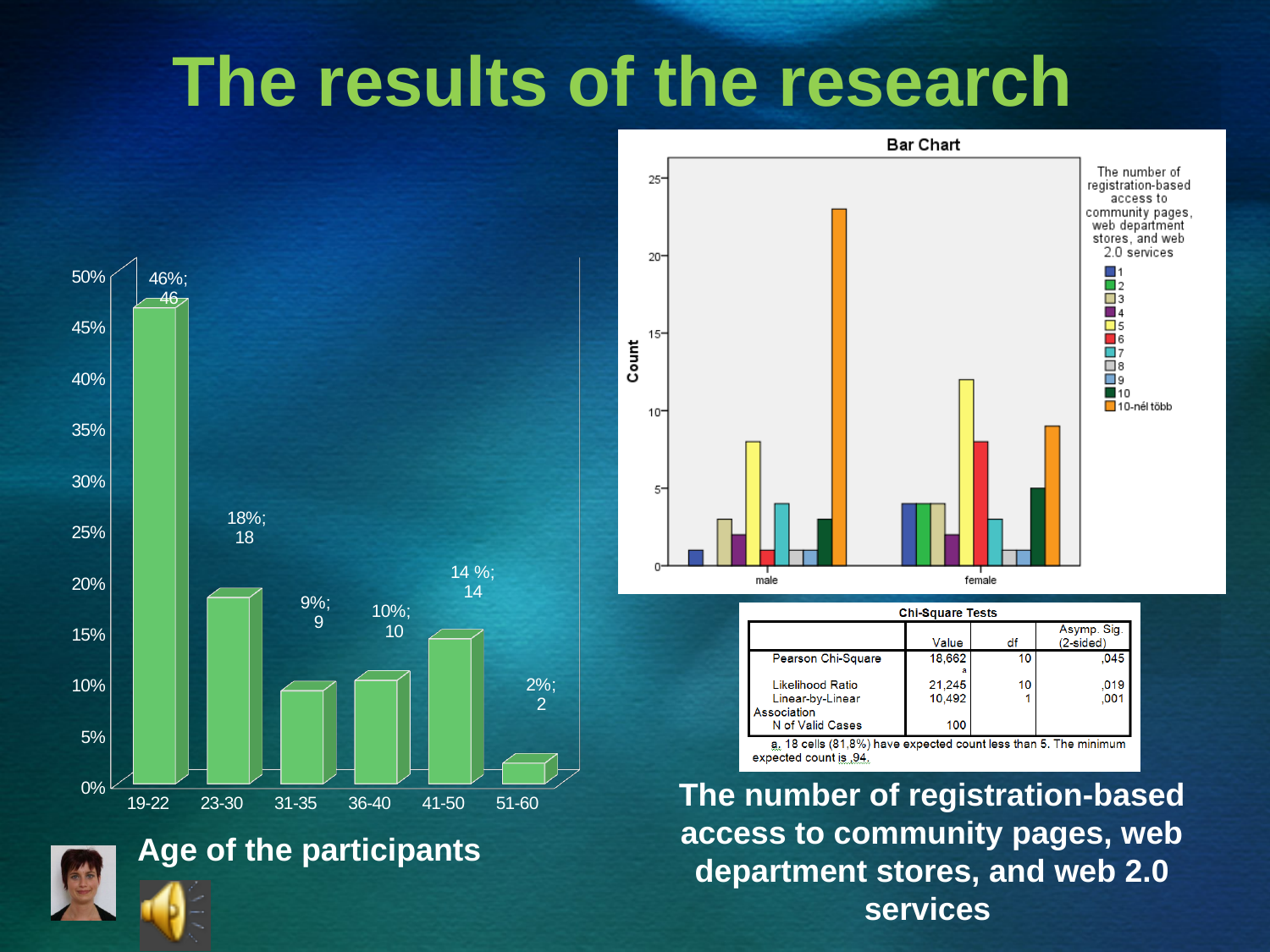
In the 'Bar Chart' on the right, is the count for category 5 among females greater or less than 10? greater What is the label of the vertical axis of the 'Bar Chart' on the right? Count In the 'Age of the participants' chart, which age group has the highest share of participants? 19-22 In the 'Age of the participants' chart, what percentage of participants are aged 19-22? 46% In the 'Bar Chart' on the right, is the count for the '10-nél több' category among males greater or less than 20? greater In the 'Age of the participants' chart, what is the difference in percentage points between the 19-22 and 23-30 age groups? 28 In the 'Age of the participants' chart, which age group has a larger share: 36-40 or 41-50? 41-50 In the 'Age of the participants' chart, what percentage of participants are aged 41-50? 14 % What type of chart is the 'Age of the participants' chart? bar chart How many entries does the legend of the 'Bar Chart' on the right list? 11 How many age groups are shown in the 'Age of the participants' chart? 6 In the 'Age of the participants' chart, which age group has the lowest share of participants? 51-60